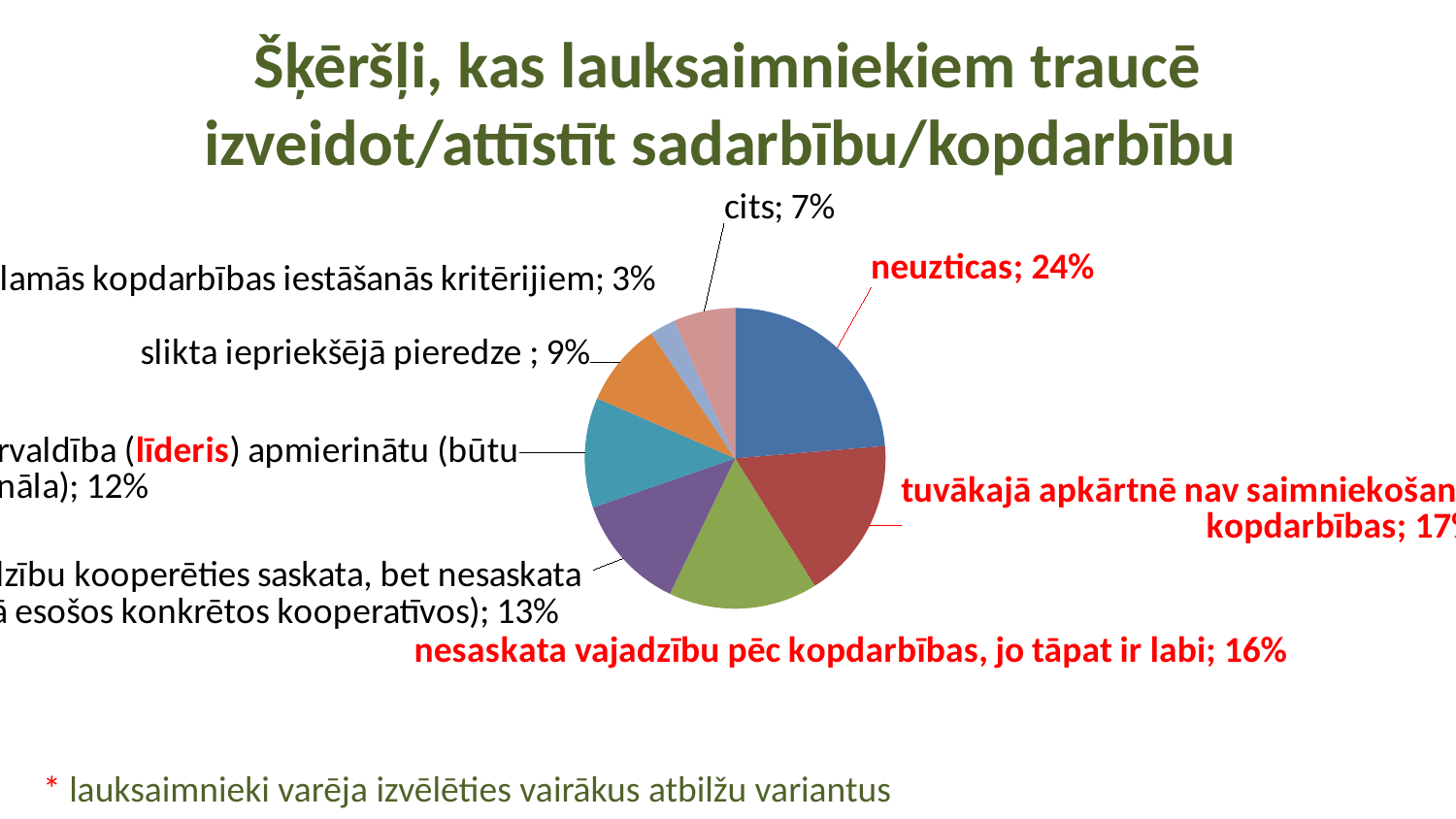
Which category has the largest share of the pie? neuzticas What percentage is shown for "cits"? 7% What is the difference in percentage points between "neuzticas" and "cits"? 17 What percentage is shown for "slikta iepriekšējā pieredze"? 9% What percentage is shown for "nesaskata vajadzību pēc kopdarbības, jo tāpat ir labi"? 16% How many slices does the pie chart have? 8 What percentage is shown for "neuzticas"? 24% What colour is the slice for "neuzticas"? blue What is the smallest percentage shown on the pie chart? 3% What is the difference in percentage points between "slikta iepriekšējā pieredze" and "cits"? 2 What type of chart is shown on the slide? pie chart Which is larger: the share for "neuzticas" or the share for "nesaskata vajadzību pēc kopdarbības, jo tāpat ir labi"? neuzticas